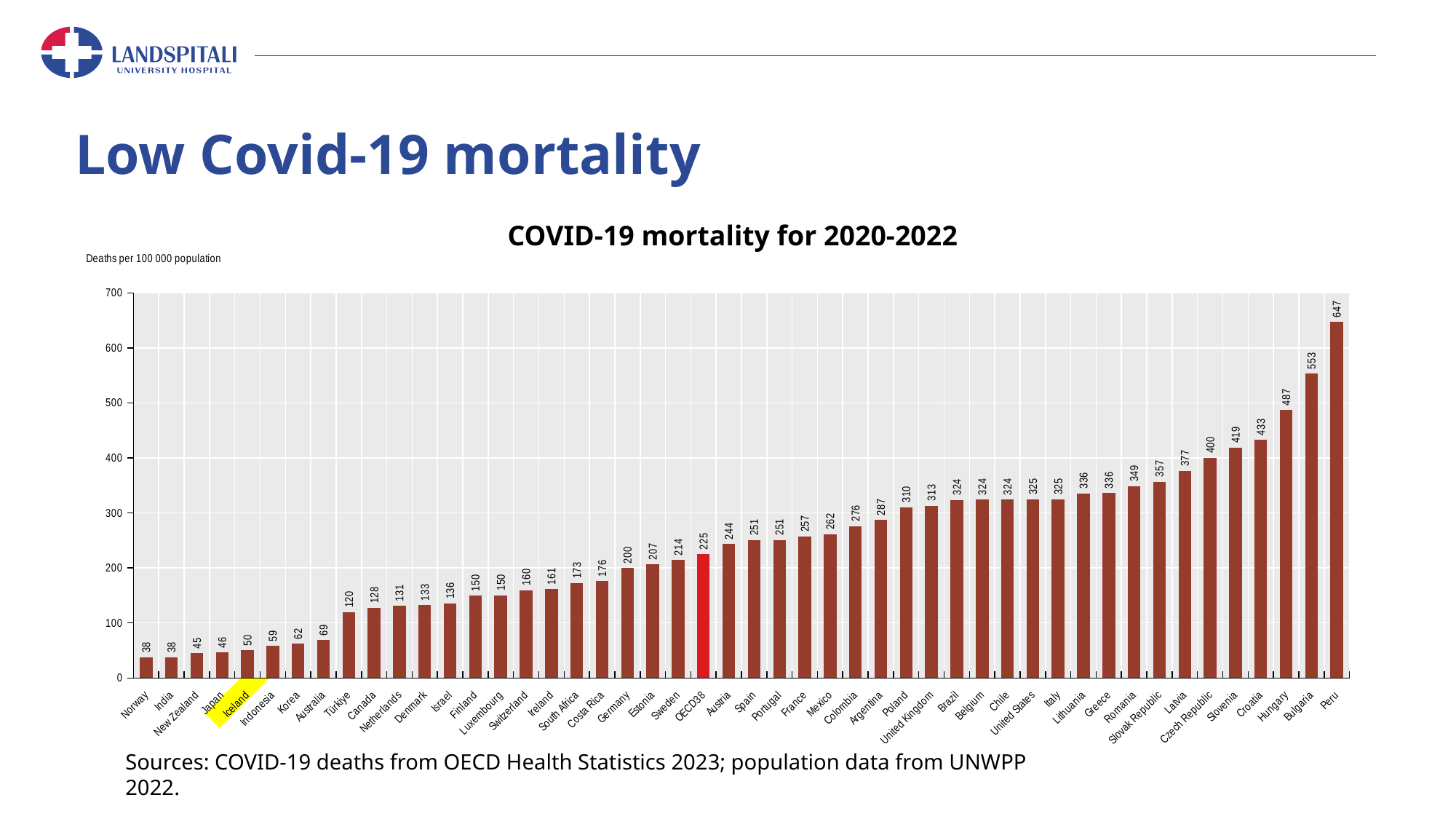
Do the values rise or fall from left to right along the x axis? Rise Is the value for Hungary greater or less than 400? greater What is the value for OECD38 in the chart? 225 What is the value for Iceland in the COVID-19 mortality chart? 50 What kind of chart is shown on the slide? Bar chart Which has a higher value, Sweden or Germany? Sweden Which bar in the chart is coloured red? OECD38 What is the value for Germany in the chart? 200 What is the lowest value shown in the chart? 38 Which country has the highest COVID-19 mortality in the chart? Peru What is the difference between the OECD38 value and the Iceland value? 175 What is the difference between the values for Peru and Bulgaria? 94